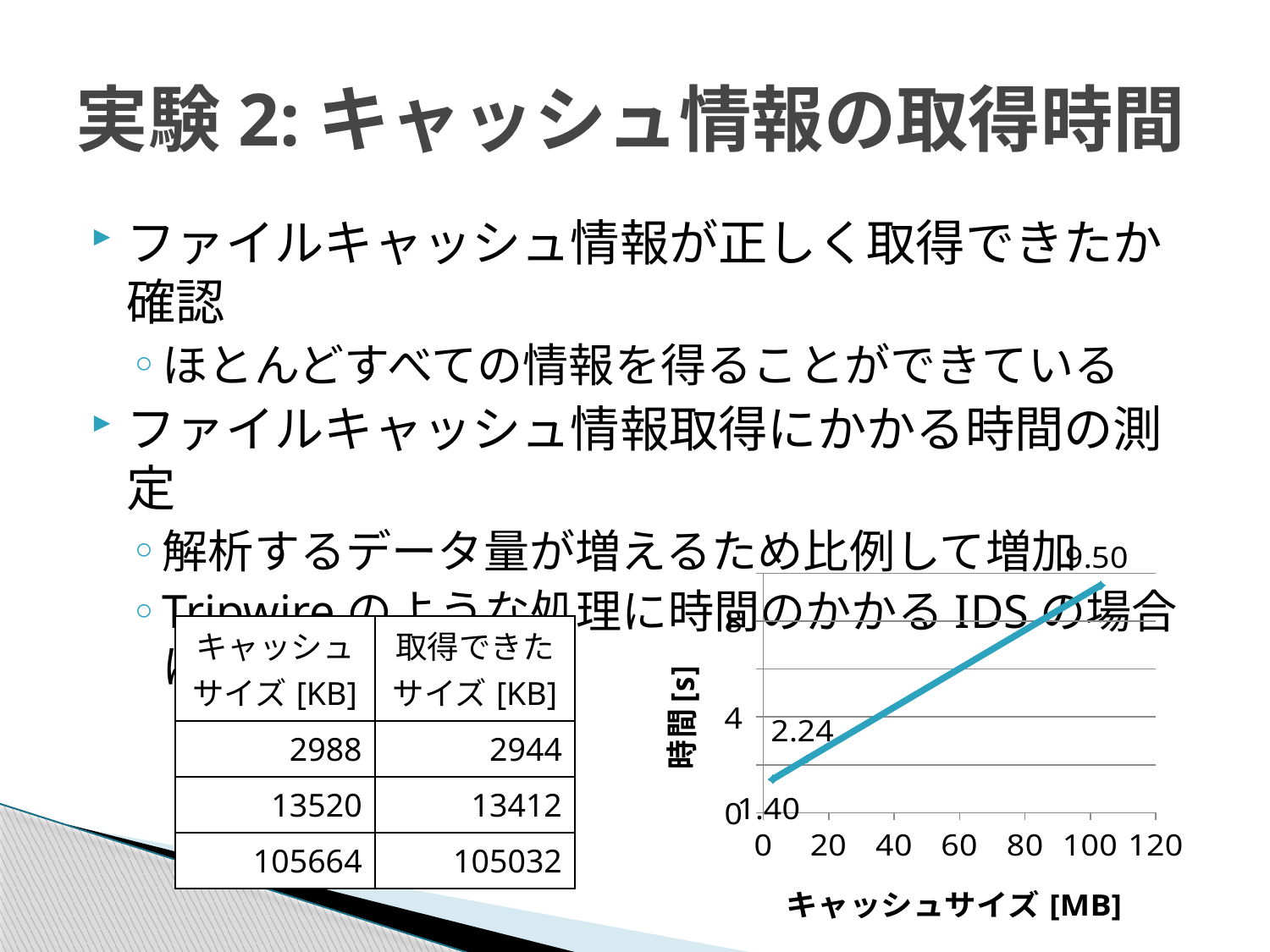
What is the y-axis title of the line chart? 時間 [s] What is the difference between the highest labelled value (9.50) and the lowest labelled value (1.40) on the line chart? 8.10 What is the lowest time value labelled on the line chart? 1.40 What kind of chart is shown on the slide? line chart What is the x-axis title of the line chart? キャッシュサイズ [MB] Does the time rise or fall as the cache size increases along the x axis of the line chart? rises Is the first point on the line chart (labelled 1.40) greater or less than 4 on the y axis? less How many data points are labelled on the line chart? 3 Which is larger on the line chart, the value labelled 2.24 or the value labelled 9.50? 9.50 What is the highest time value labelled on the line chart? 9.50 What is the difference between the labelled values 2.24 and 1.40 on the line chart? 0.84 Is the highest point on the line chart greater or less than 8 on the y axis? greater